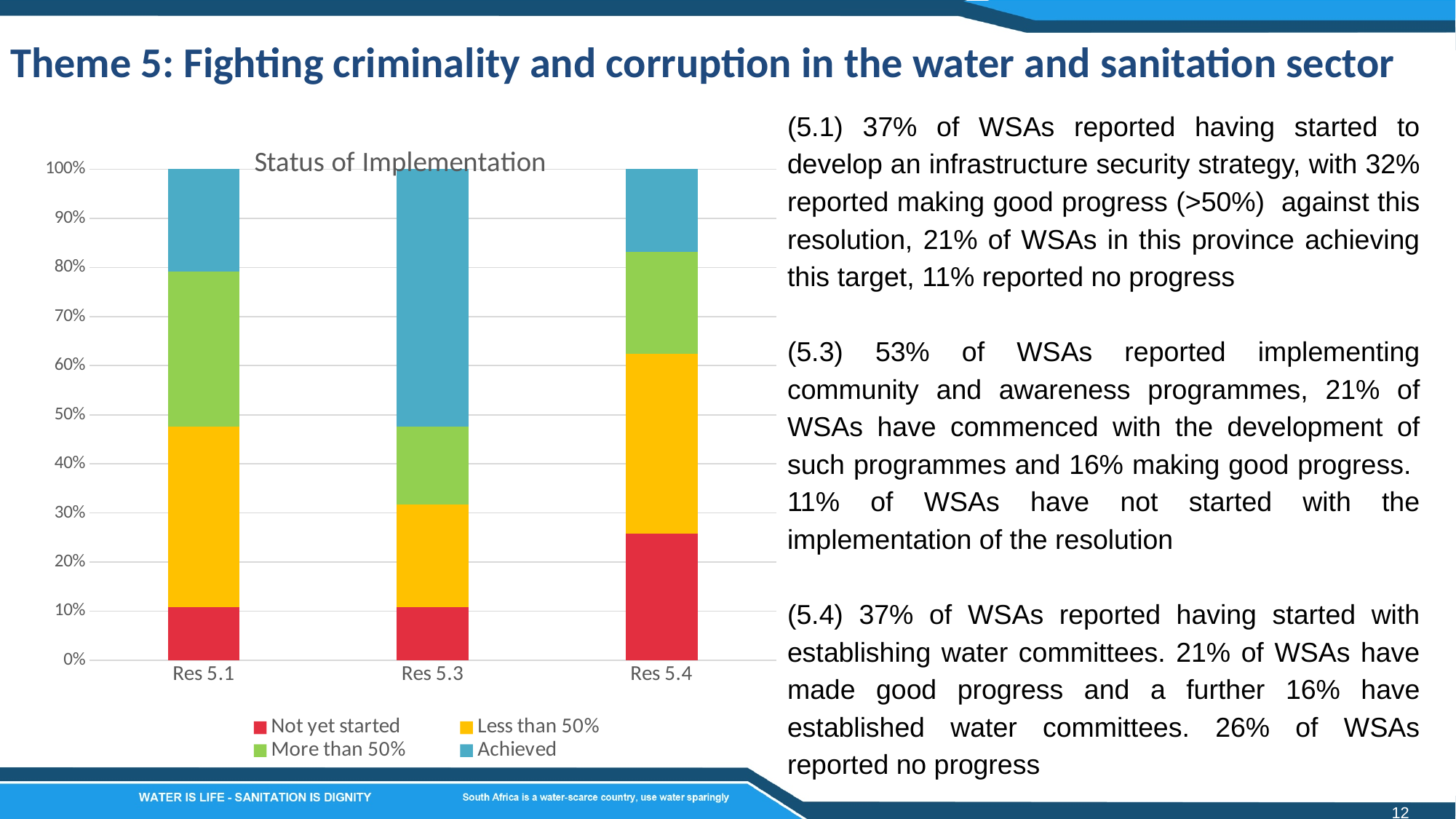
Is the 'Not yet started' segment for Res 5.4 greater or less than 20%? greater Which category has the smallest 'Less than 50%' segment? Res 5.3 How many categories are shown on the x axis of the chart? 3 What kind of chart is shown on the slide? Stacked bar chart Is the 'Achieved' segment for Res 5.3 greater or less than 50%? greater What is the title of the chart? Status of Implementation Which is larger: the 'Not yet started' segment for Res 5.4 or for Res 5.1? Res 5.4 How many series does the chart legend list? 4 What is the total height of the stacked bar for Res 5.1? 100% Which category has the largest 'Not yet started' segment? Res 5.4 Which category has the largest 'Achieved' segment? Res 5.3 Which colour represents the 'Achieved' series in the chart? Blue